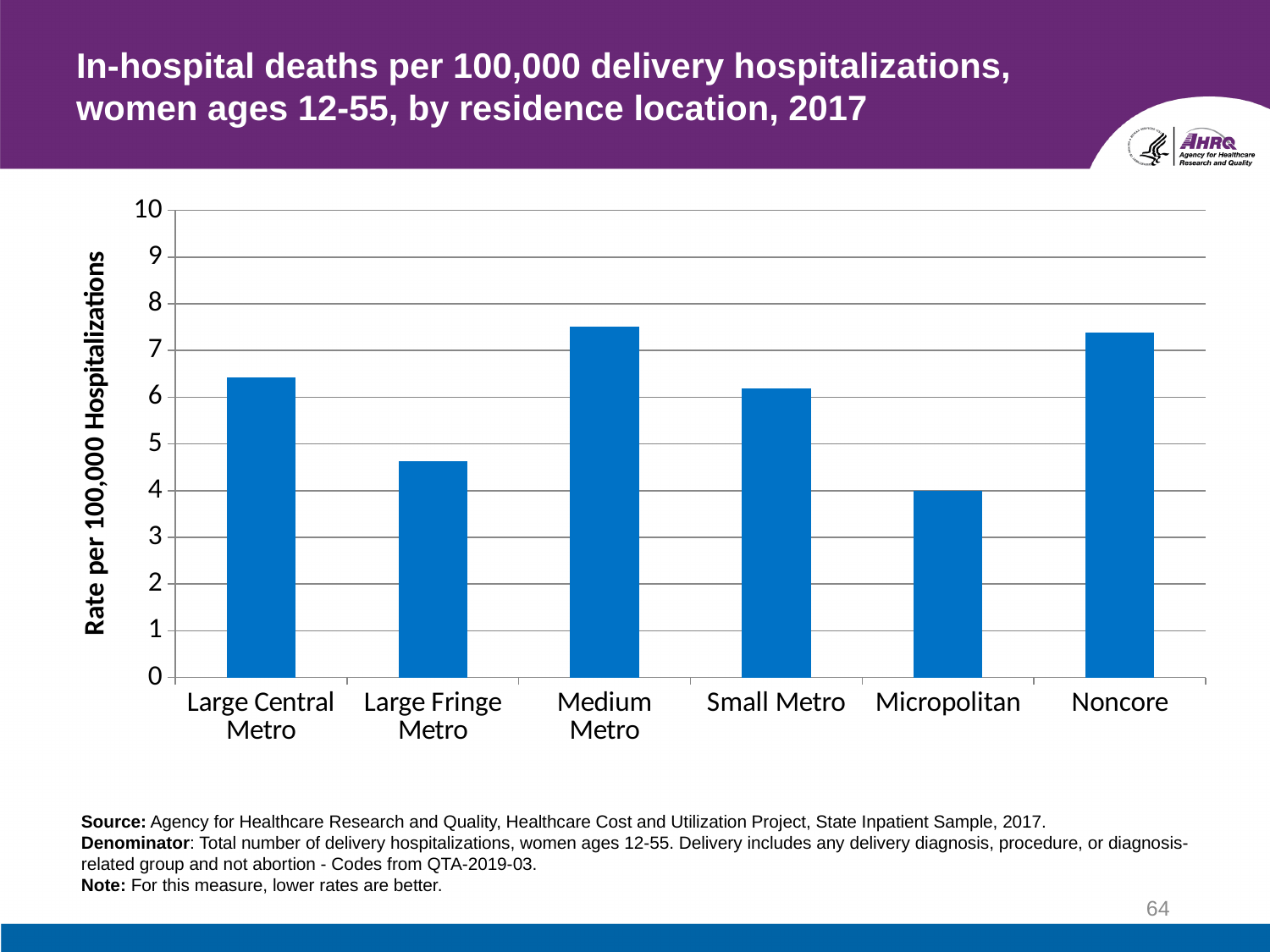
Is the value for Noncore greater or less than 7? greater Is the value for Large Central Metro greater or less than 6? greater What kind of chart is shown on the slide? Bar chart Which residence location has the lowest in-hospital death rate? Micropolitan Which is larger, the value for Large Central Metro or the value for Large Fringe Metro? Large Central Metro Which is larger, the value for Noncore or the value for Micropolitan? Noncore What is the label on the y axis of the chart? Rate per 100,000 Hospitalizations Is the value for Large Fringe Metro greater or less than 5? less How many residence location categories are shown on the x axis? 6 Which is larger, the value for Medium Metro or the value for Small Metro? Medium Metro